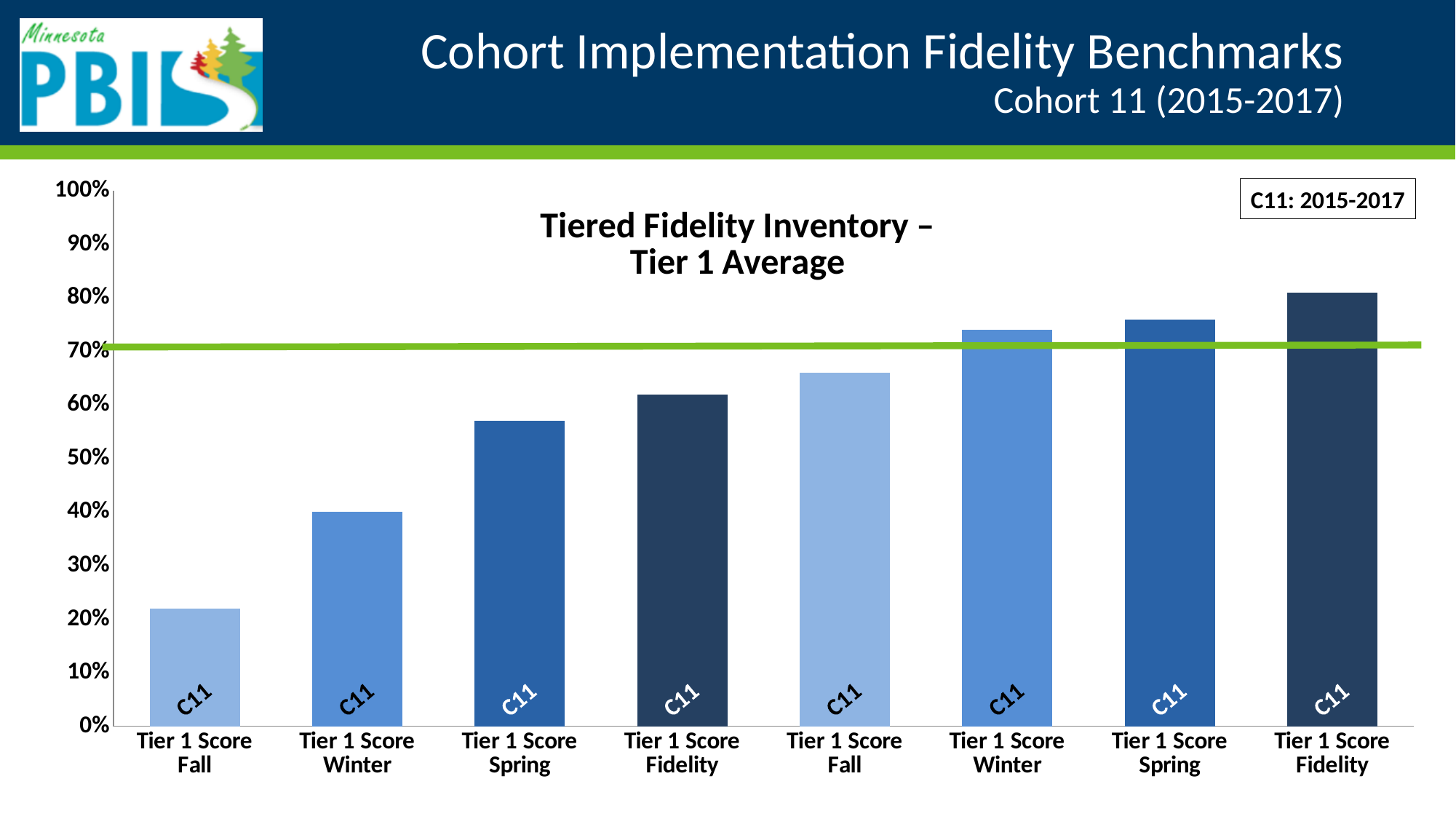
What is the title of the chart? Tiered Fidelity Inventory – Tier 1 Average What type of chart is shown on the slide? Bar chart Which bar has the lowest value? The leftmost Tier 1 Score Fall bar Which bar has the highest value? The rightmost Tier 1 Score Fidelity bar Do the bar values generally rise or fall from left to right? Rise Is the value of the leftmost Tier 1 Score Fall bar greater or less than 30%? less Is the value of the second (right) Tier 1 Score Winter bar greater or less than 70%? greater Is the value of the first (left) Tier 1 Score Spring bar greater or less than 50%? greater How many bars are plotted in the chart? 8 At what percentage level is the green horizontal line drawn across the chart? 70% Which is larger, the first Tier 1 Score Winter bar or the first Tier 1 Score Spring bar? The first Tier 1 Score Spring bar